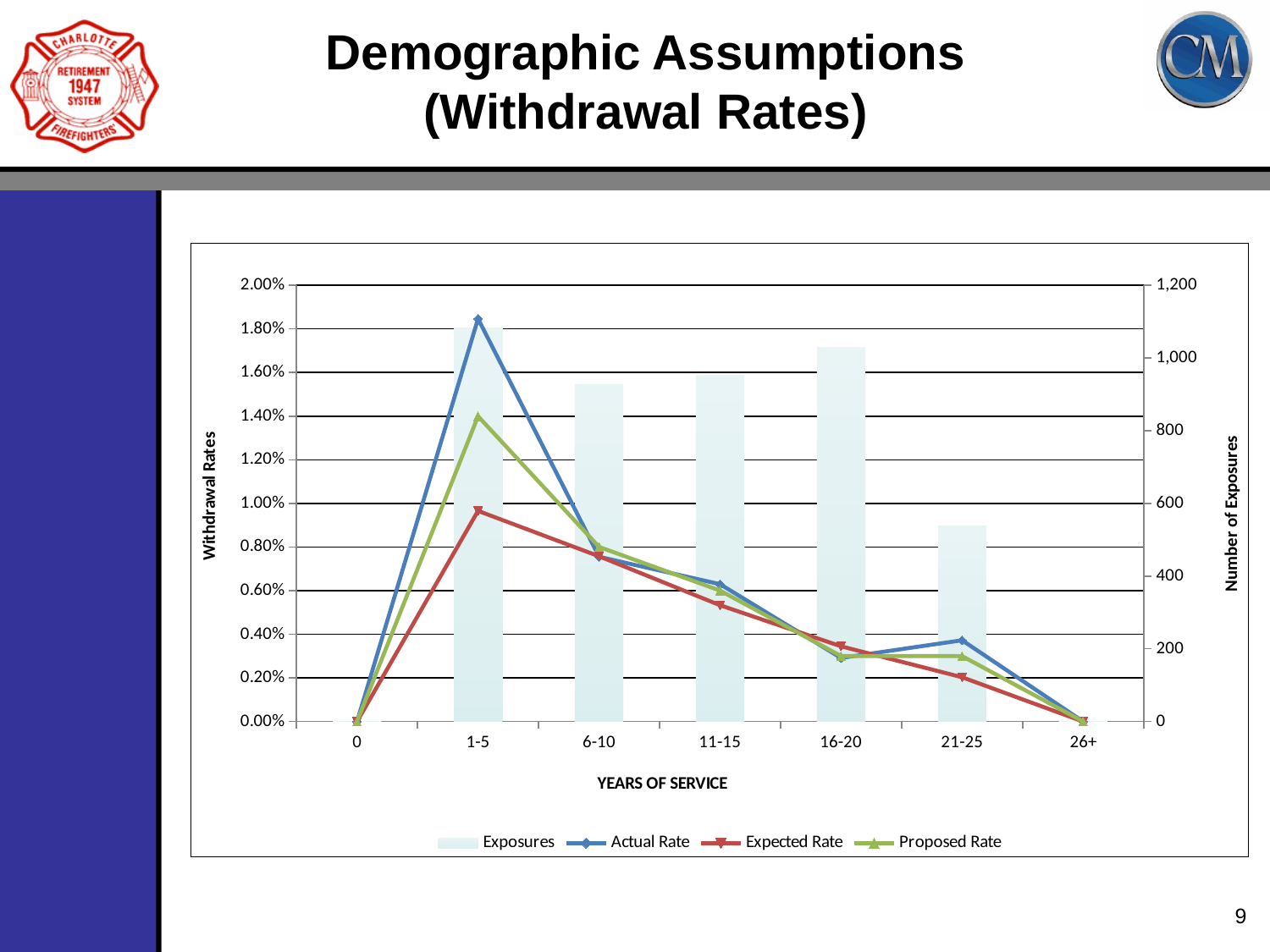
How many years-of-service categories are shown on the x axis? 7 Is the number of Exposures for 21-25 years of service greater or less than 800? less At 1-5 years of service, which is larger: the Proposed Rate or the Expected Rate? Proposed Rate What is the title of the x axis? YEARS OF SERVICE Among the categories with Exposures bars, which has the lowest number of Exposures? 21-25 Does the Expected Rate rise or fall from 1-5 years of service to 26+ years of service? fall At 1-5 years of service, which is larger: the Actual Rate or the Expected Rate? Actual Rate Is the Expected Rate for 1-5 years of service greater or less than 1.20%? less Is the Actual Rate for 1-5 years of service greater or less than 1.60%? greater How many series does the chart legend list? 4 At which years-of-service category does the Actual Rate reach its highest value? 1-5